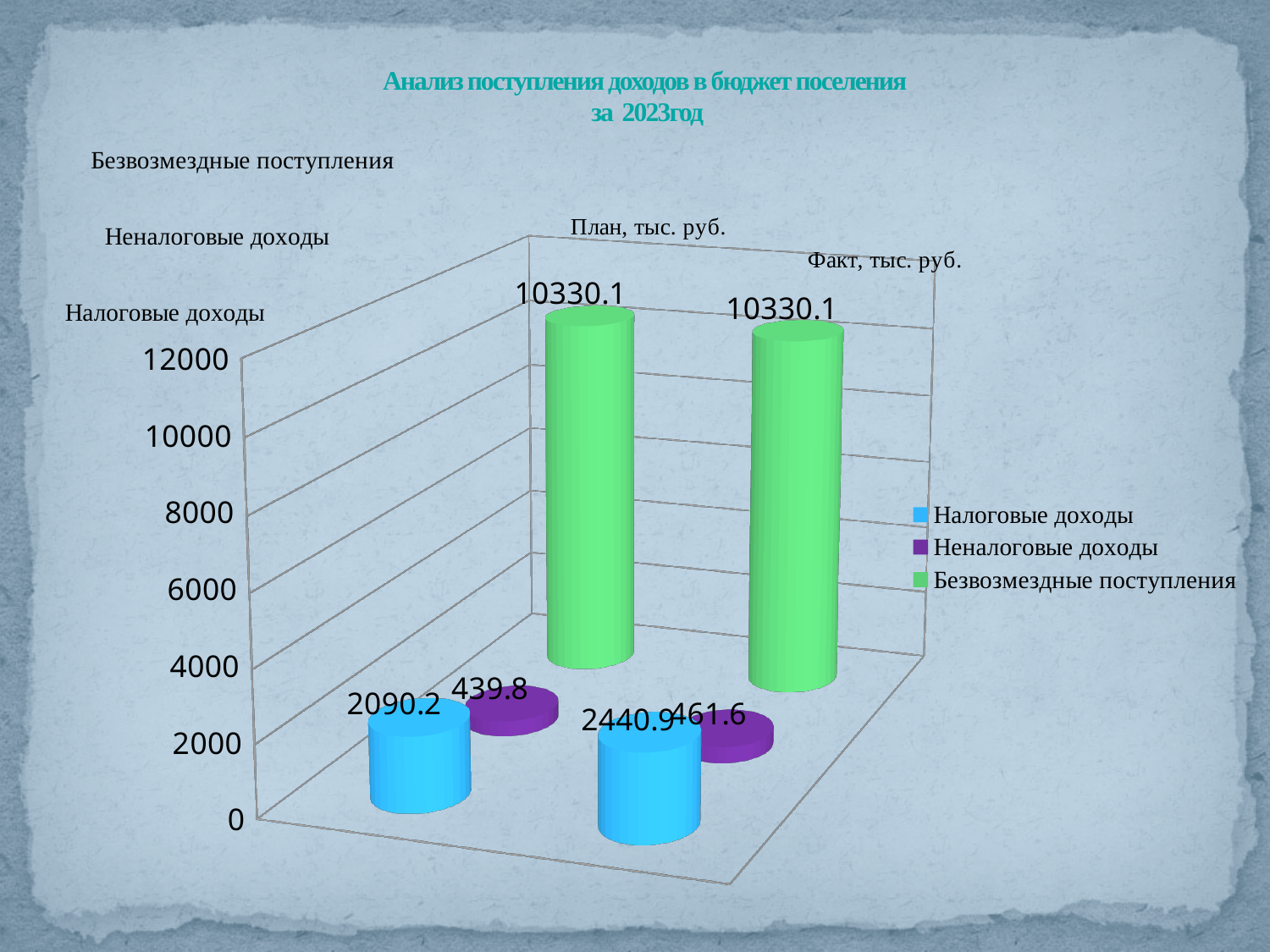
Which series has the lowest value for Факт, тыс. руб.? Неналоговые доходы What is the value of Неналоговые доходы for Факт, тыс. руб.? 461.6 What is the title of the chart? Анализ поступления доходов в бюджет поселения за 2023год What is the difference between the Факт and План values for Налоговые доходы? 350.7 Which is larger: Неналоговые доходы for План or for Факт? Факт What is the value of Налоговые доходы for План, тыс. руб.? 2090.2 What kind of chart is shown on the slide? bar chart What is the value of Неналоговые доходы for План, тыс. руб.? 439.8 How many series does the legend list? 3 What is the value of Безвозмездные поступления for Факт, тыс. руб.? 10330.1 Which series has the highest value for План, тыс. руб.? Безвозмездные поступления What is the value of Налоговые доходы for Факт, тыс. руб.? 2440.9